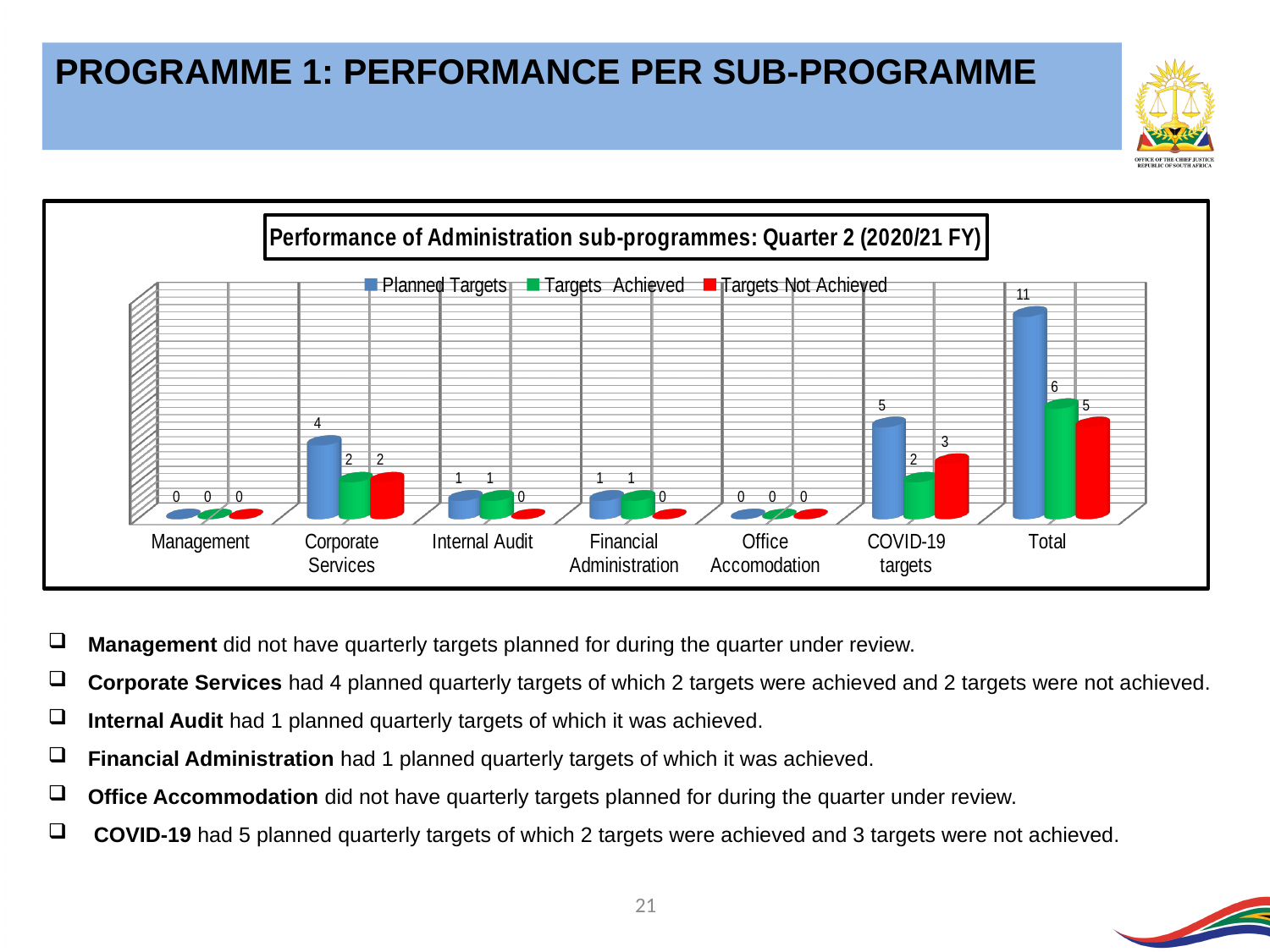
Which is larger: Targets Achieved for Corporate Services or Targets Achieved for Total? Total How many categories are shown on the x axis? 7 What is the title of the chart? Performance of Administration sub-programmes: Quarter 2 (2020/21 FY) How many series does the legend list? 3 Which category has the highest Planned Targets value? Total Which colour represents Targets Not Achieved in the legend? Red What is the Planned Targets value for Corporate Services? 4 What is the Targets Achieved value for Total? 6 What is the difference between Planned Targets and Targets Achieved for COVID-19 targets? 3 Excluding Total, which sub-programme has the highest Planned Targets value? COVID-19 targets What kind of chart is shown? Bar chart What is the Targets Not Achieved value for COVID-19 targets? 3